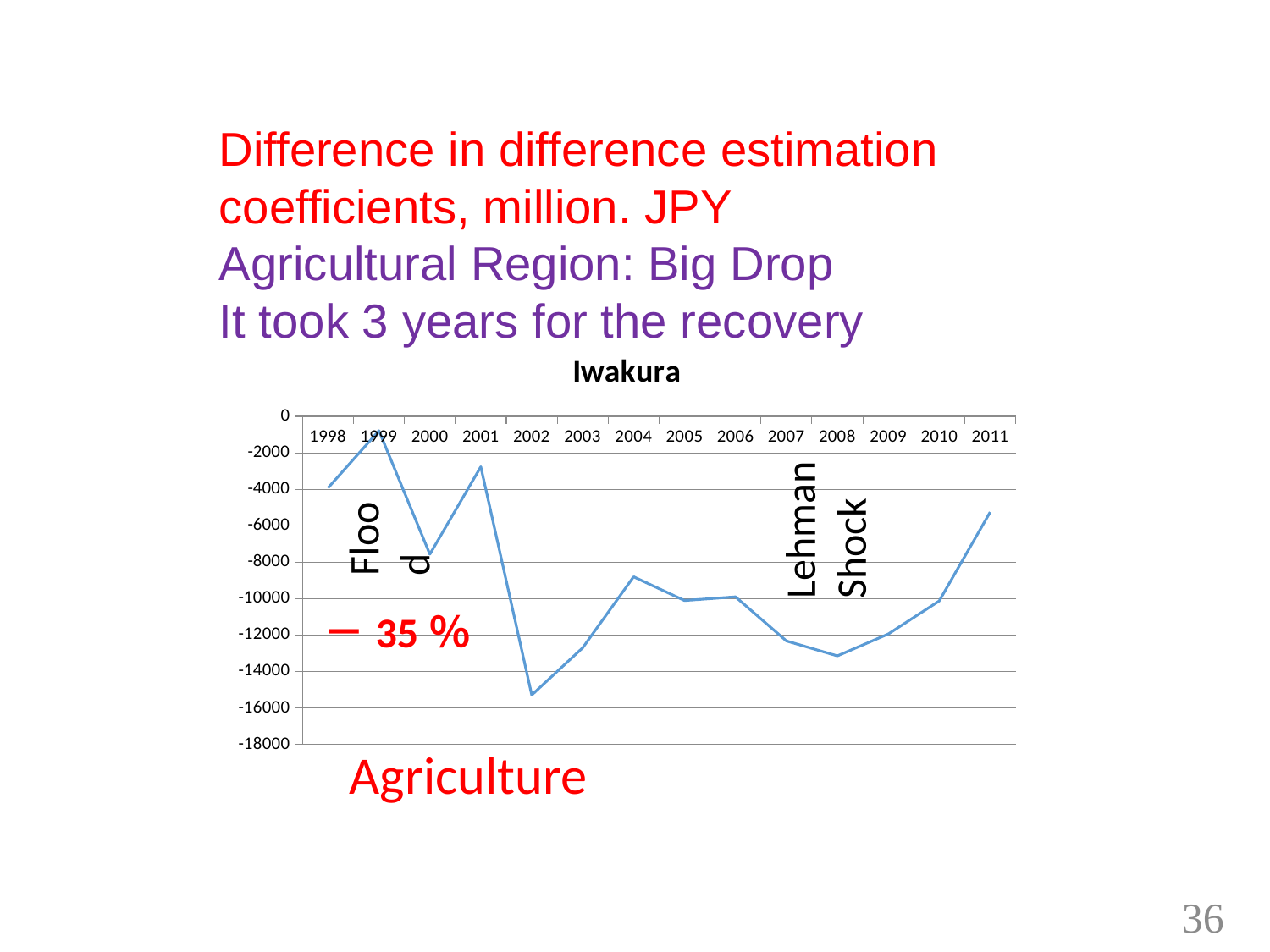
Is the value for 2001 greater or less than -4000? greater Is the value for 2008 greater or less than -12000? less What is the title of the chart? Iwakura Do the values rise or fall from 2008 to 2011? rise Which year has the highest value on the chart? 1999 Do the values rise or fall from 2001 to 2002? fall How many years are plotted along the x axis of the chart? 14 What kind of chart is shown on the slide? line chart Which year has the larger value, 2004 or 2007? 2004 Which year has the lowest value on the chart? 2002 Is the value for 2011 greater or less than -6000? greater